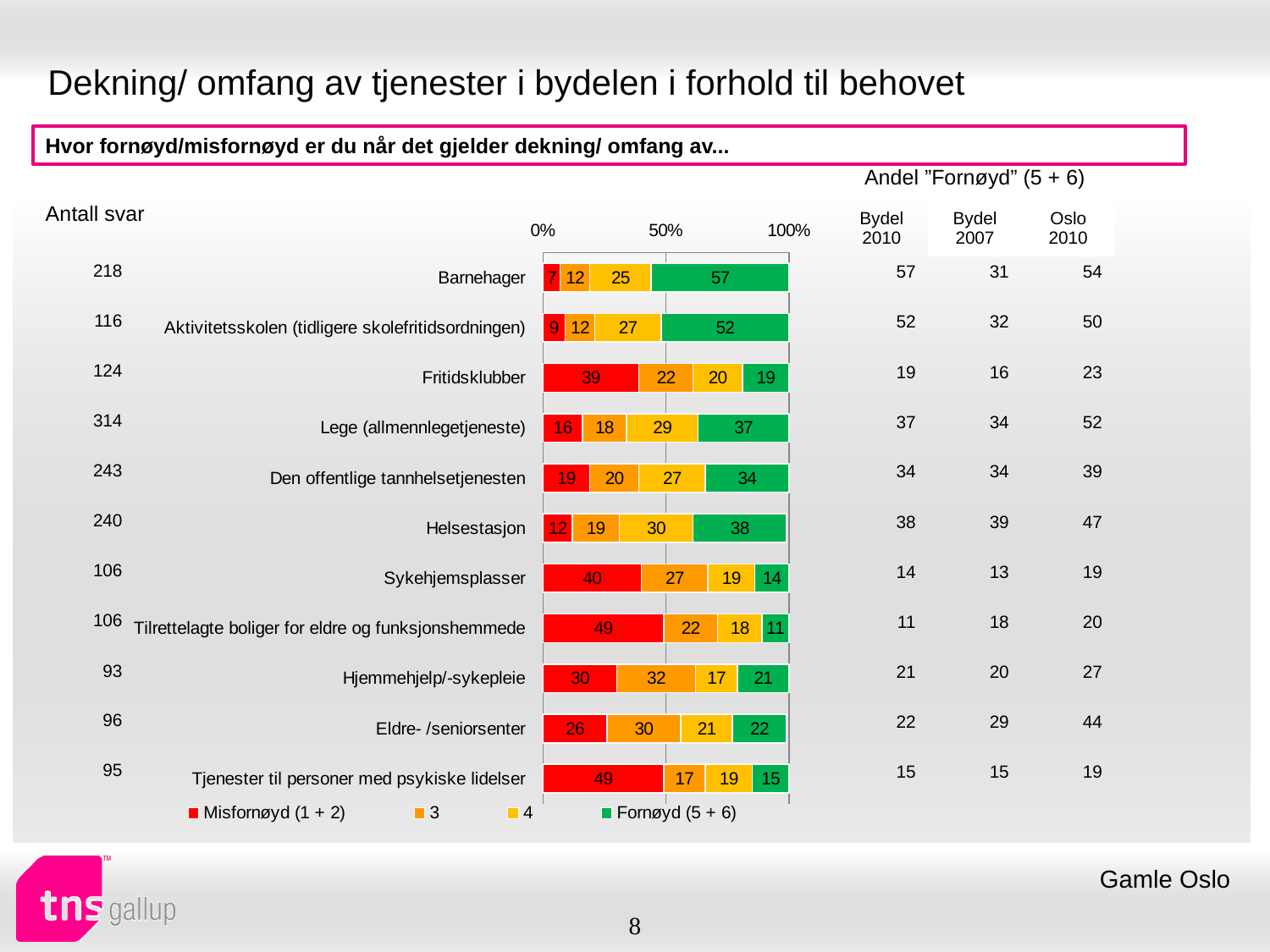
Which category has the highest Fornøyd (5 + 6) value? Barnehager Which category has the lowest Fornøyd (5 + 6) value? Tilrettelagte boliger for eldre og funksjonshemmede How many categories are shown in the bar chart? 11 What is the value of the Fornøyd (5 + 6) segment for Barnehager? 57 What is the total of the stacked bar for Fritidsklubber? 100 What kind of chart is shown on the slide? Stacked bar chart How many series does the legend list? 4 Which legend entry is shown in green? Fornøyd (5 + 6) What is the value of the '3' segment for Hjemmehjelp/-sykepleie? 32 Which is larger: the Fornøyd (5 + 6) value for Lege (allmennlegetjeneste) or for Helsestasjon? Helsestasjon What is the difference between the Misfornøyd (1 + 2) values for Fritidsklubber and Eldre- /seniorsenter? 13 What is the value of the Misfornøyd (1 + 2) segment for Sykehjemsplasser? 40